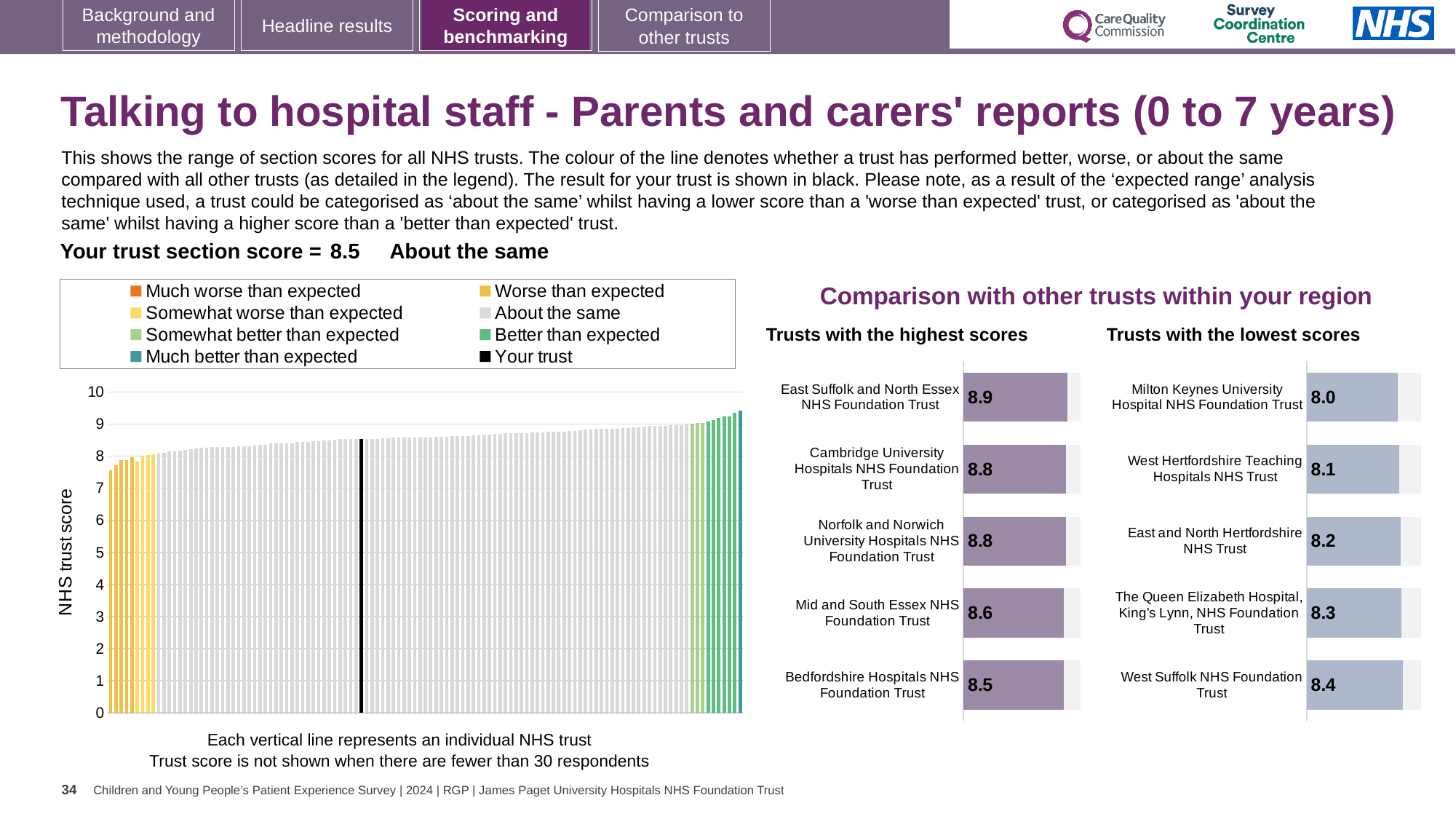
In the 'Trusts with the highest scores' chart, what is the score for Norfolk and Norwich University Hospitals NHS Foundation Trust? 8.8 How many entries does the legend above the large chart on the left list? 8 In the 'Trusts with the lowest scores' chart, what is the score for Milton Keynes University Hospital NHS Foundation Trust? 8.0 In the 'Trusts with the highest scores' chart, what is the difference between the scores of East Suffolk and North Essex NHS Foundation Trust and Bedfordshire Hospitals NHS Foundation Trust? 0.4 In the 'Trusts with the lowest scores' chart, how many trusts are listed? 5 In the 'Trusts with the highest scores' chart, which trust has the highest score? East Suffolk and North Essex NHS Foundation Trust In the large chart on the left showing the range of section scores, is the value of the rightmost bar greater or less than 9? greater In the large chart on the left showing the range of section scores, is the value of the leftmost bar greater or less than 8? less In the 'Trusts with the lowest scores' chart, which trust has the lowest score? Milton Keynes University Hospital NHS Foundation Trust Which has the higher score: Mid and South Essex NHS Foundation Trust in the 'highest scores' chart or West Suffolk NHS Foundation Trust in the 'lowest scores' chart? Mid and South Essex NHS Foundation Trust In the 'Trusts with the highest scores' chart, what is the score for East Suffolk and North Essex NHS Foundation Trust? 8.9 In the large chart on the left showing the range of section scores, do the values rise or fall from left to right? rise